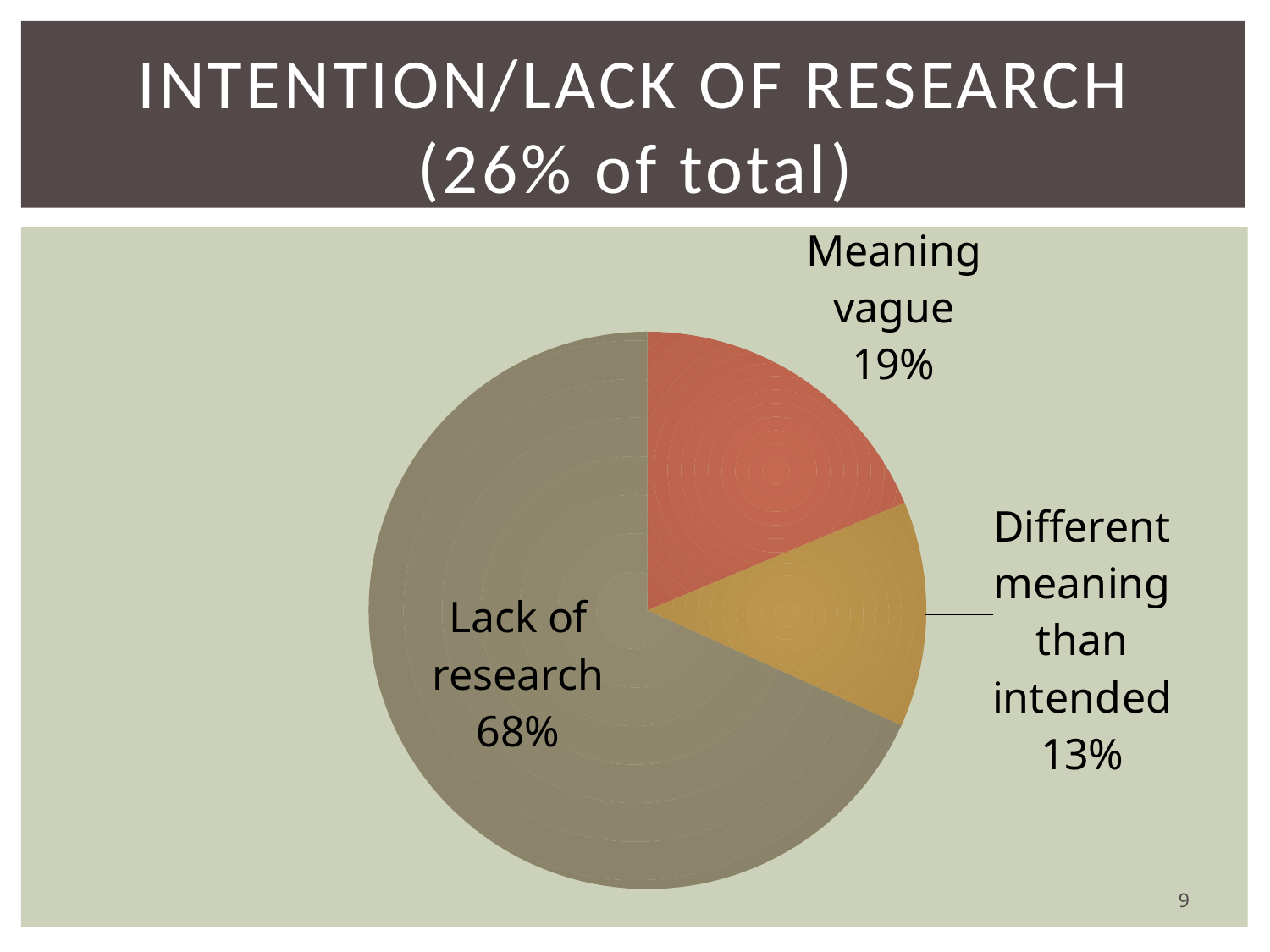
What kind of chart is shown on the slide? Pie chart Which slice of the pie is the largest? Lack of research What is the title of the slide containing the pie chart? INTENTION/LACK OF RESEARCH (26% of total) What is the difference between the "Lack of research" share and the "Meaning vague" share? 49% What share of the pie does "Meaning vague" take? 19% What share of the pie does "Lack of research" take? 68% What colour is the "Meaning vague" slice? Red Which slice of the pie is the smallest? Different meaning than intended What is the difference between the "Meaning vague" share and the "Different meaning than intended" share? 6% What share of the pie does "Different meaning than intended" take? 13% Which is larger, the "Meaning vague" slice or the "Different meaning than intended" slice? Meaning vague How many slices does the pie chart have? 3